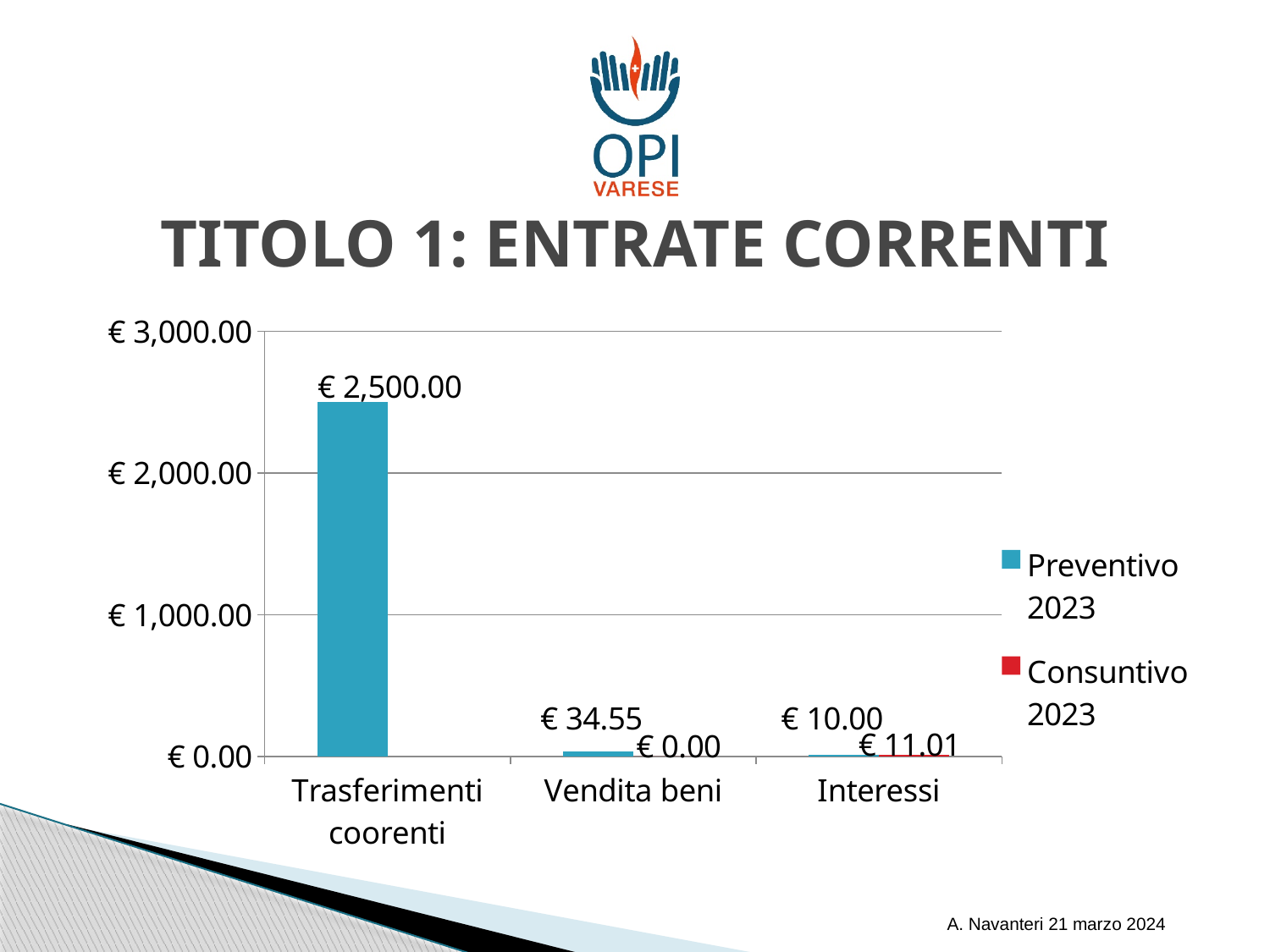
What is the Preventivo 2023 value for Interessi? € 10.00 What is the Consuntivo 2023 value for Vendita beni? € 0.00 What kind of chart is shown on the slide? Bar chart What is the Preventivo 2023 value for Vendita beni? € 34.55 For Interessi, which is larger: Preventivo 2023 or Consuntivo 2023? Consuntivo 2023 What is the Preventivo 2023 value for Trasferimenti coorenti? € 2,500.00 For Vendita beni, what is the difference between the Preventivo 2023 and Consuntivo 2023 values? € 34.55 How many categories are shown on the x axis? 3 How many series does the legend list? 2 What is the Consuntivo 2023 value for Interessi? € 11.01 For Interessi, how much larger is the Consuntivo 2023 value than the Preventivo 2023 value? € 1.01 Which category has the highest Preventivo 2023 value? Trasferimenti coorenti